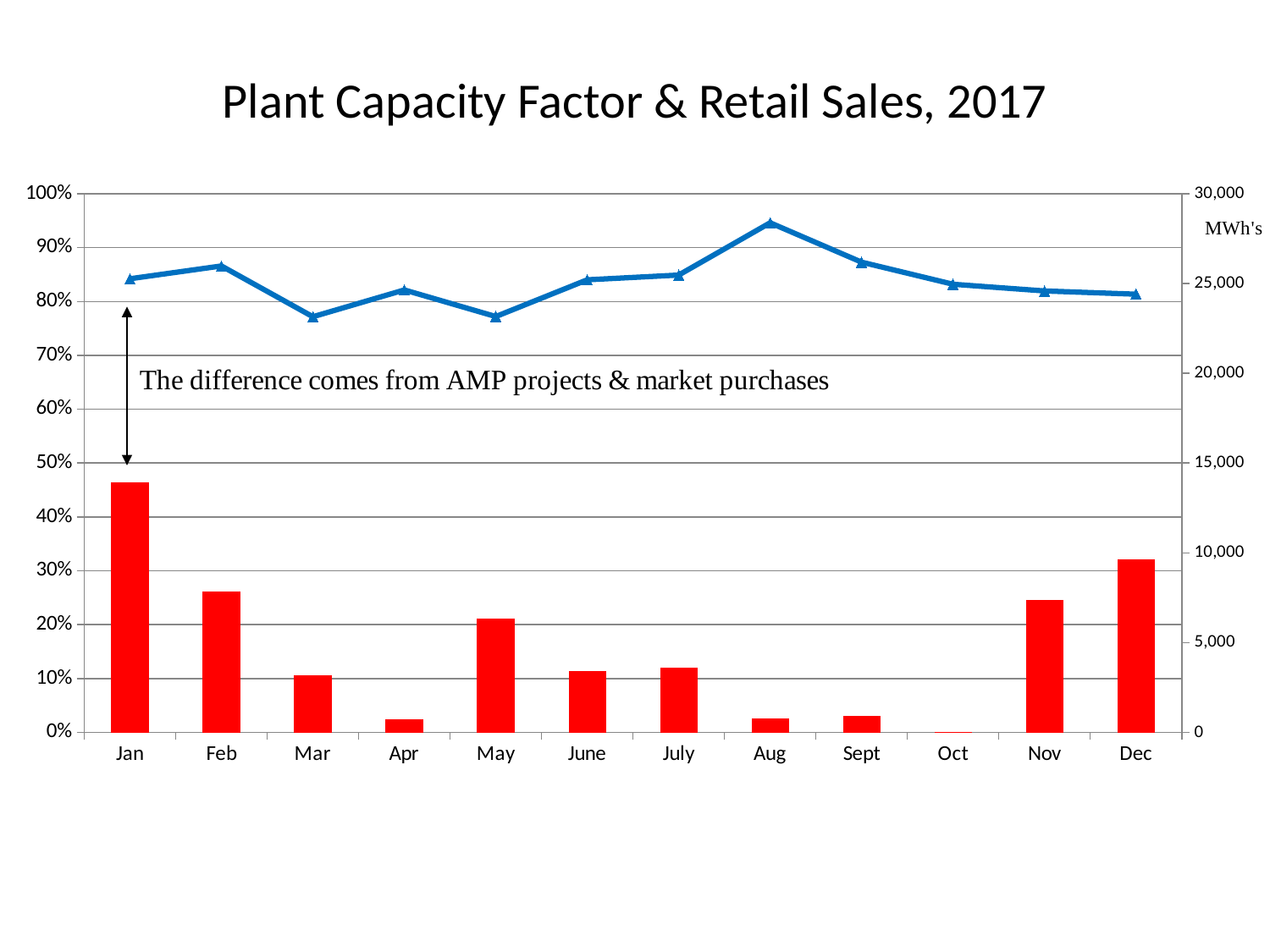
Does the blue line rise or fall from Aug to Dec? fall What kind of chart is shown on the slide? A combined bar and line chart In which month does the blue line reach its highest point? Aug Is the blue line value for Mar greater or less than 25,000? less Is the red bar for Jan greater or less than 40%? greater Which month has no visible red bar (the lowest bar value)? Oct What unit is labelled on the right-hand axis? MWh's Which month has the taller red bar, Nov or Dec? Dec How many months are shown along the x axis? 12 Which month has the tallest red bar? Jan Is the red bar for Dec greater or less than 30%? greater